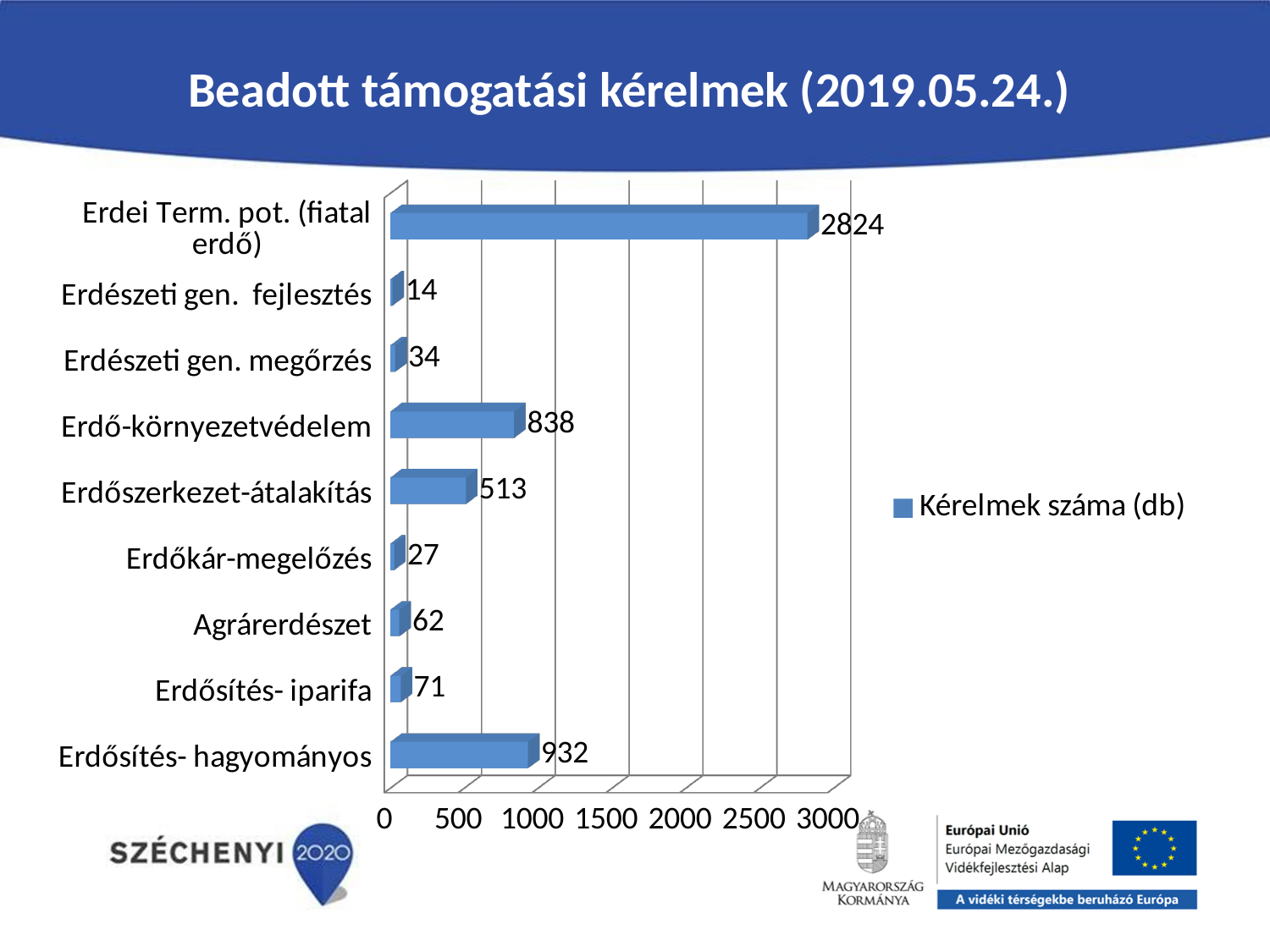
How many categories are shown in the chart? 9 What is the value for Erdő-környezetvédelem? 838 What is the value for Erdősítés- hagyományos? 932 What is the difference between the values for Erdősítés- hagyományos and Erdő-környezetvédelem? 94 Which category has the lowest value? Erdészeti gen. fejlesztés Which category has the highest value? Erdei Term. pot. (fiatal erdő) Is the value for Erdei Term. pot. (fiatal erdő) greater or less than 2500? greater Which is larger, the value for Erdőszerkezet-átalakítás or the value for Erdő-környezetvédelem? Erdő-környezetvédelem What is the value for Erdészeti gen. fejlesztés? 14 What kind of chart is shown on the slide? bar chart What is the legend entry of the chart? Kérelmek száma (db) How many series does the legend list? 1